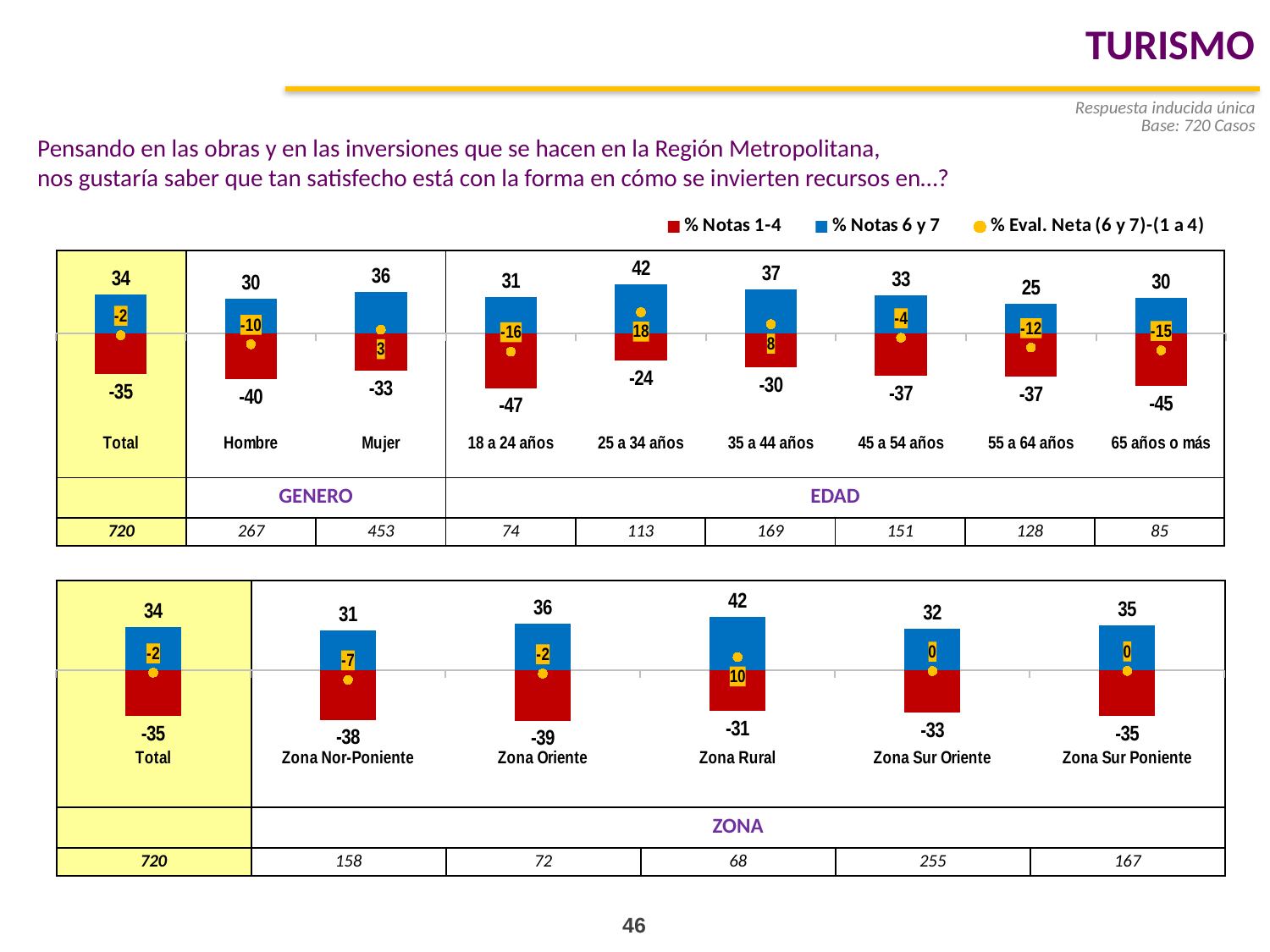
In the top chart, which age group has the highest % Notas 6 y 7 value? 25 a 34 años In the top chart, what is the % Notas 6 y 7 value for Mujer? 36 In the top chart, which has a higher % Eval. Neta value, Hombre or Mujer? Mujer In the bottom chart, what is the % Eval. Neta value for Zona Sur Oriente? 0 In the bottom chart, what is the % Notas 1-4 value for Zona Oriente? -39 In the top chart, what is the difference between the % Notas 6 y 7 values for Mujer and Hombre? 6 How many series does the legend list? 3 In the top chart, what is the % Notas 1-4 value for 18 a 24 años? -47 In the top chart, what is the % Eval. Neta value for 25 a 34 años? 18 In the top chart, which age group has the lowest % Notas 6 y 7 value? 55 a 64 años What kind of chart is the bottom chart? Bar chart In the bottom chart, which zona has the highest % Notas 6 y 7 value? Zona Rural